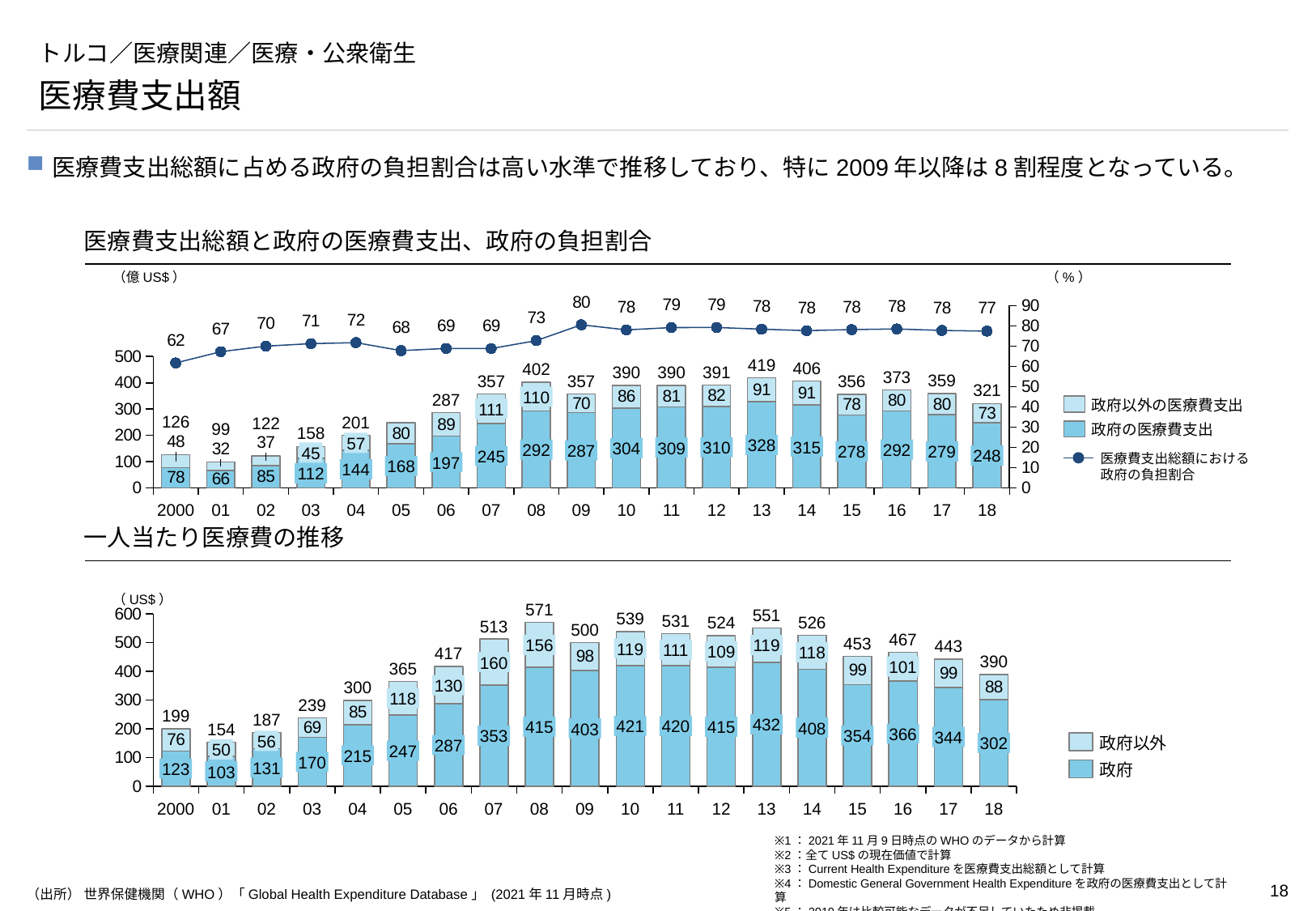
How many series does the legend of the top chart list? 3 In the bottom chart (一人当たり医療費の推移), which year has the highest total per-capita health expenditure? 08 In the bottom chart, what is the 政府 value for 18? 302 In the top chart, does the government share line rise or fall from 2000 to 04? rise How many years are plotted on the x axis of the bottom chart? 19 In the top chart, what is the lowest total health expenditure shown, and in which year? 99 in 01 In the top chart, what is the value of 政府の医療費支出 for 13? 328 In the top chart, which year has the highest total health expenditure? 13 In the bottom chart, what is the 政府以外 value for 07? 160 In the bottom chart, which is larger: the 政府 value for 13 or for 18? 13 In the top chart, what is the difference between 政府の医療費支出 in 13 and in 18? 80 In the top chart (医療費支出総額と政府の医療費支出、政府の負担割合), in which year is the government share (政府の負担割合) line highest? 09